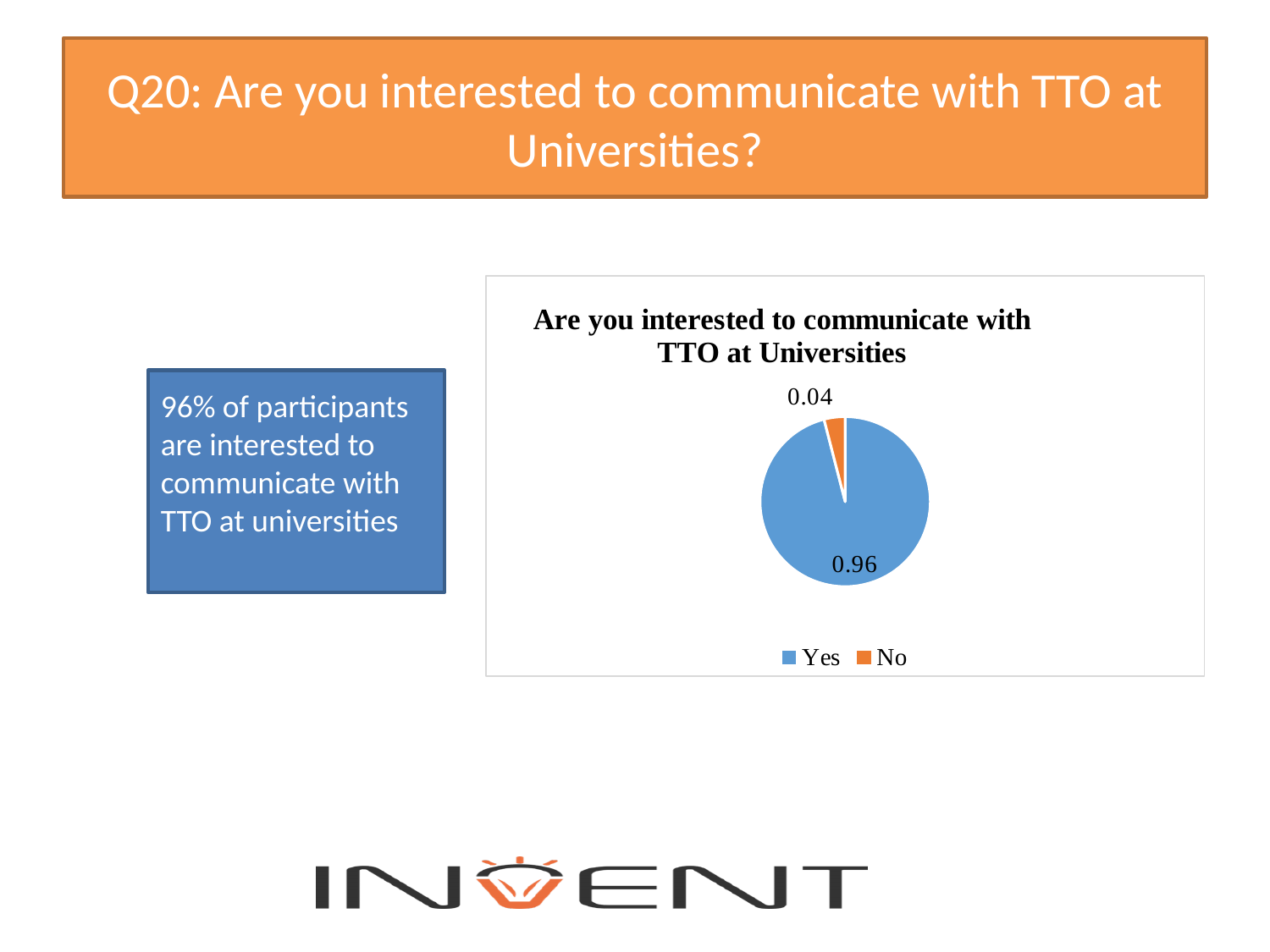
Which category has the largest slice of the pie? Yes What is the title of the chart? Are you interested to communicate with TTO at Universities How many entries does the legend list? 2 What is the difference between the Yes value and the No value? 0.92 What is the value shown for the No slice? 0.04 How many slices does the pie chart have? 2 What colour is the Yes slice in the pie chart? blue What is the value shown for the Yes slice? 0.96 Which category has the smallest slice of the pie? No What is the total of the two values shown on the pie chart? 1 What kind of chart is shown on the slide? pie chart Which is larger, the Yes slice or the No slice? Yes